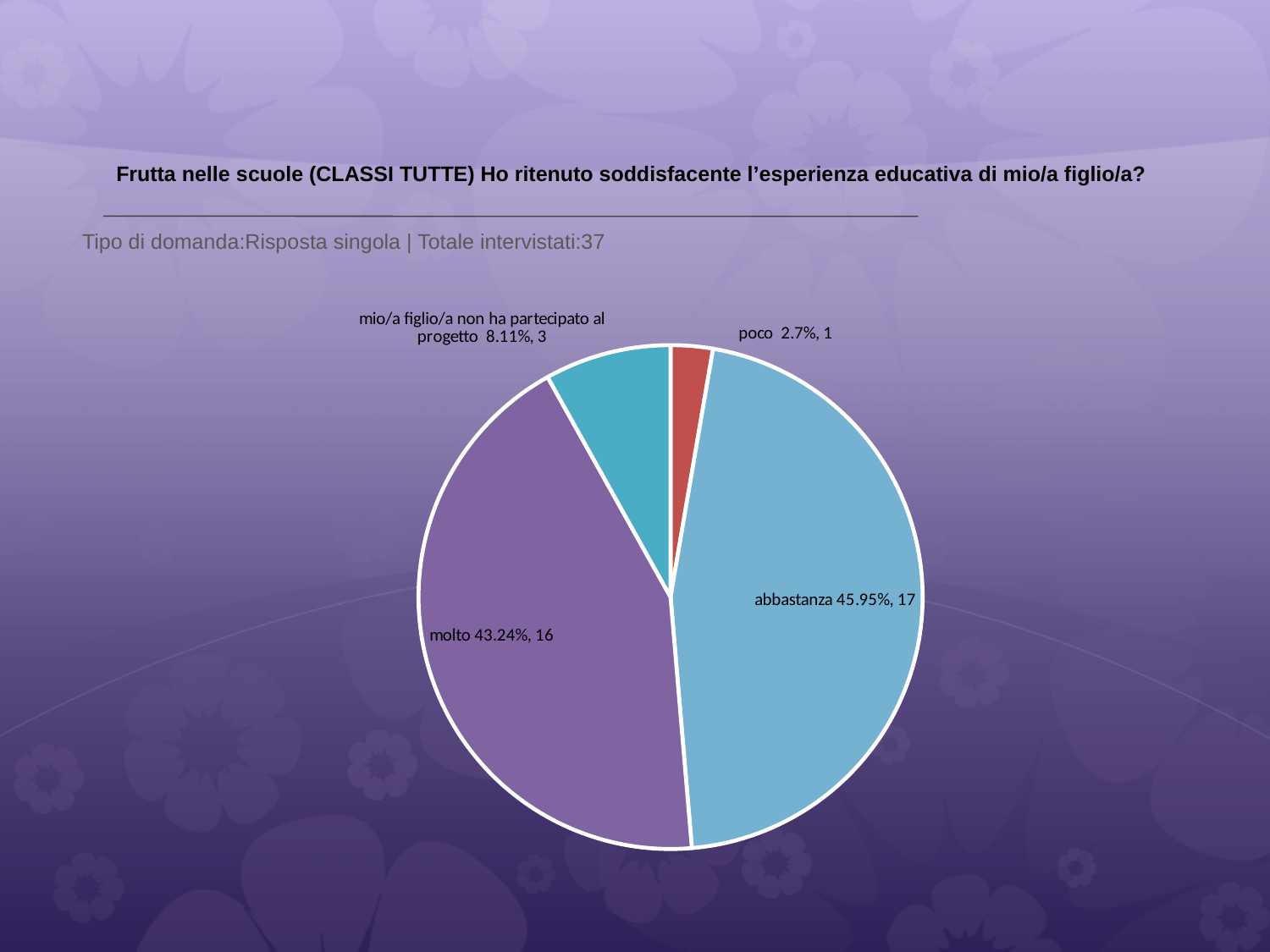
Which response has the largest slice of the pie? abbastanza What is the total number of respondents (Totale intervistati) stated on the slide? 37 Which has more respondents, 'mio/a figlio/a non ha partecipato al progetto' or 'poco'? mio/a figlio/a non ha partecipato al progetto What kind of chart is shown on the slide? pie chart What percentage share does the 'abbastanza' slice have? 45.95% What is the difference in respondent count between 'abbastanza' and 'molto'? 1 What percentage share does the 'molto' slice have? 43.24% How many respondents answered 'molto'? 16 How many slices does the pie chart have? 4 Which response has the smallest slice of the pie? poco What percentage share does the 'mio/a figlio/a non ha partecipato al progetto' slice have? 8.11% How many respondents answered 'poco'? 1